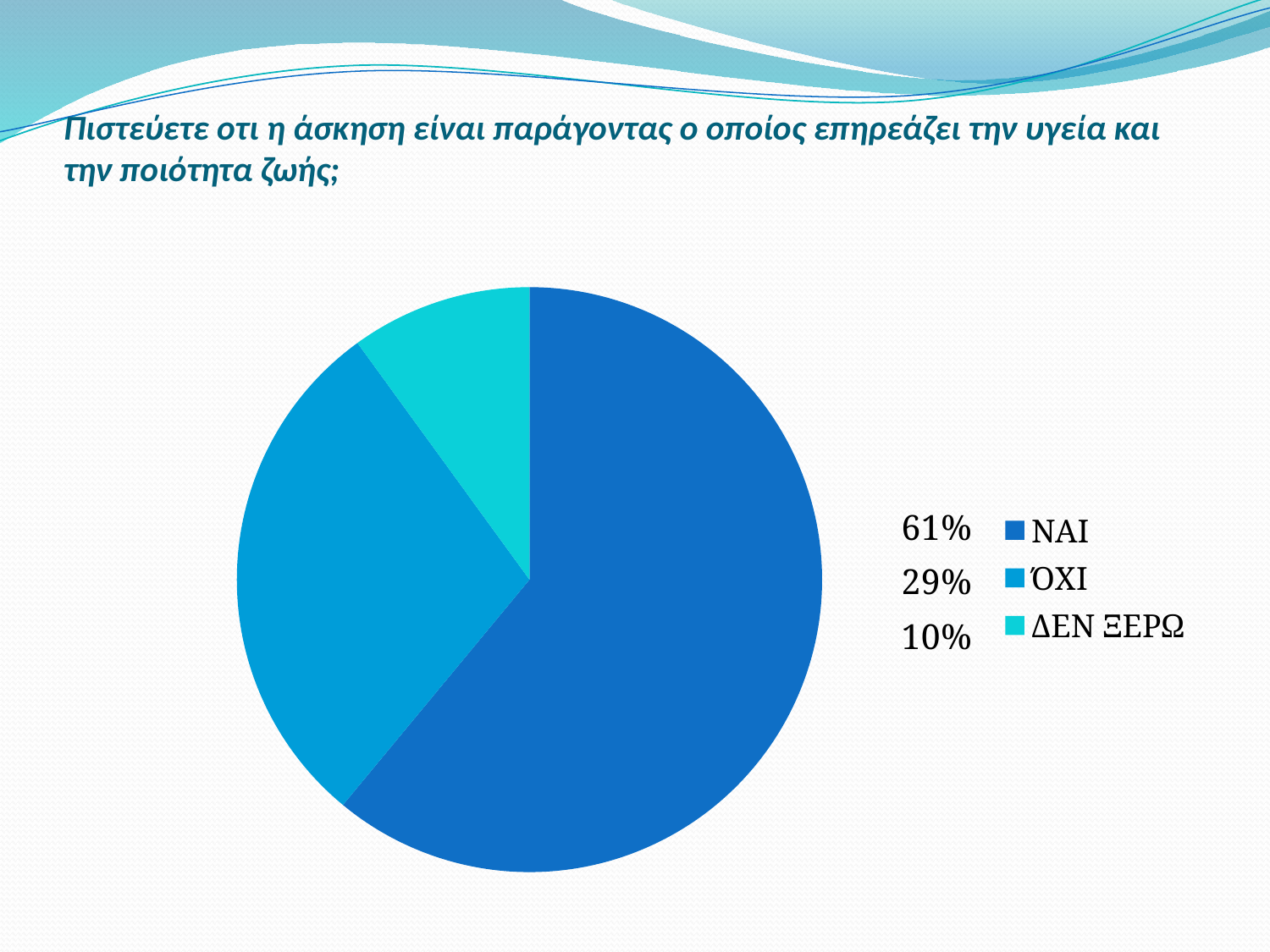
What percentage of respondents answered ΝΑΙ? 61% What percentage of respondents answered ΔΕΝ ΞΕΡΩ? 10% How many slices does the pie chart have? 3 What is the difference in percentage points between ΌΧΙ and ΔΕΝ ΞΕΡΩ? 19 Which response has the smallest share of the pie? ΔΕΝ ΞΕΡΩ What percentage of respondents answered ΌΧΙ? 29% What kind of chart is shown on the slide? pie chart What colour is the slice for ΔΕΝ ΞΕΡΩ? light turquoise Which is larger, the share for ΌΧΙ or the share for ΔΕΝ ΞΕΡΩ? ΌΧΙ What is the difference in percentage points between ΝΑΙ and ΌΧΙ? 32 Which response has the largest share of the pie? ΝΑΙ How many entries does the legend list? 3